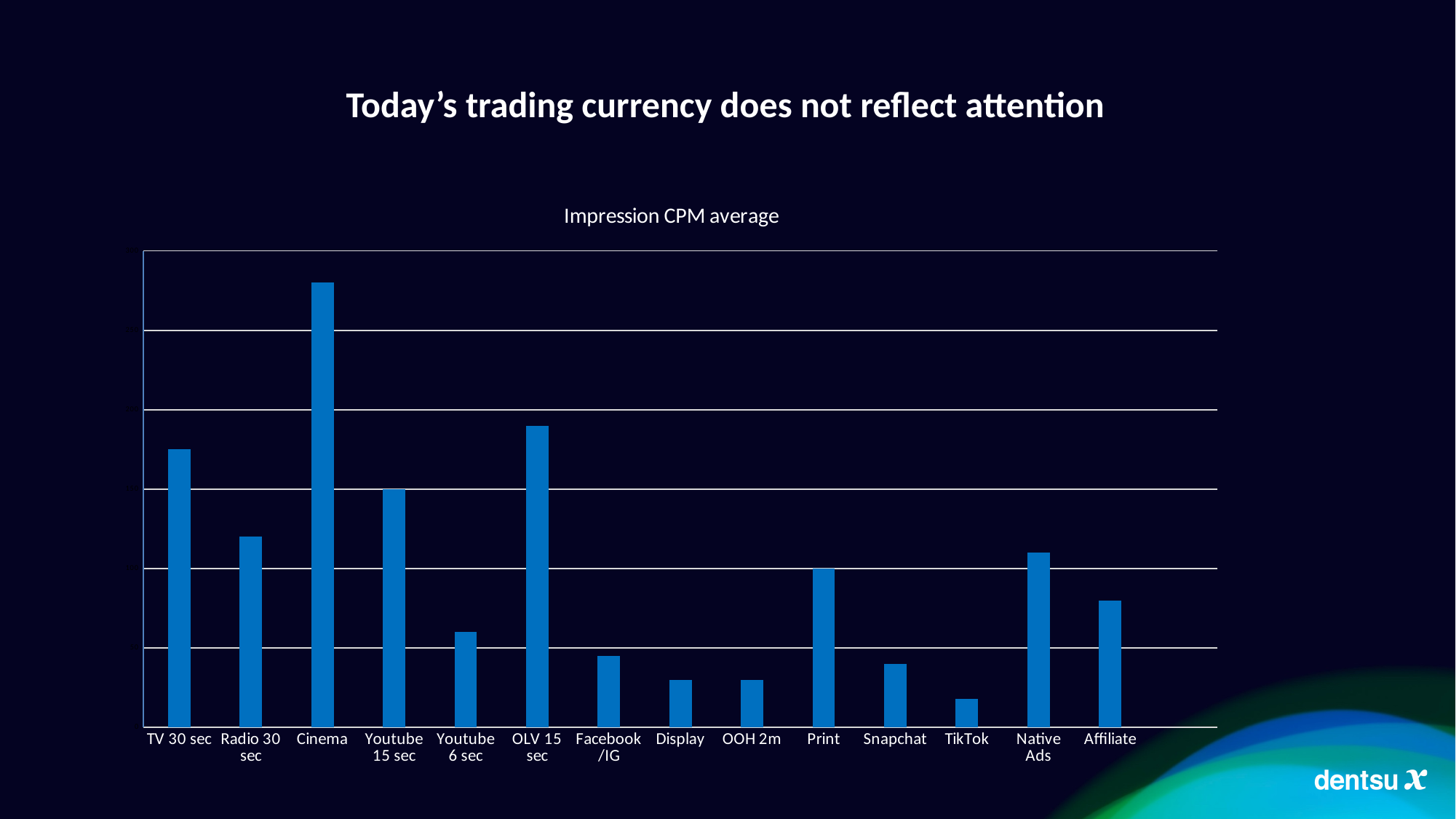
Which category has the second-highest bar in the chart? OLV 15 sec What type of chart is shown on the slide? bar chart Which category has the lowest Impression CPM average? TikTok Which is larger, the value for Snapchat or the value for TikTok? Snapchat Which is larger, the value for Youtube 15 sec or the value for Youtube 6 sec? Youtube 15 sec How many categories are plotted on the x axis of the chart? 14 Which category has the highest Impression CPM average? Cinema Which is larger, the value for Affiliate or the value for Print? Print What is the title of the slide? Today's trading currency does not reflect attention What is the title of the chart? Impression CPM average